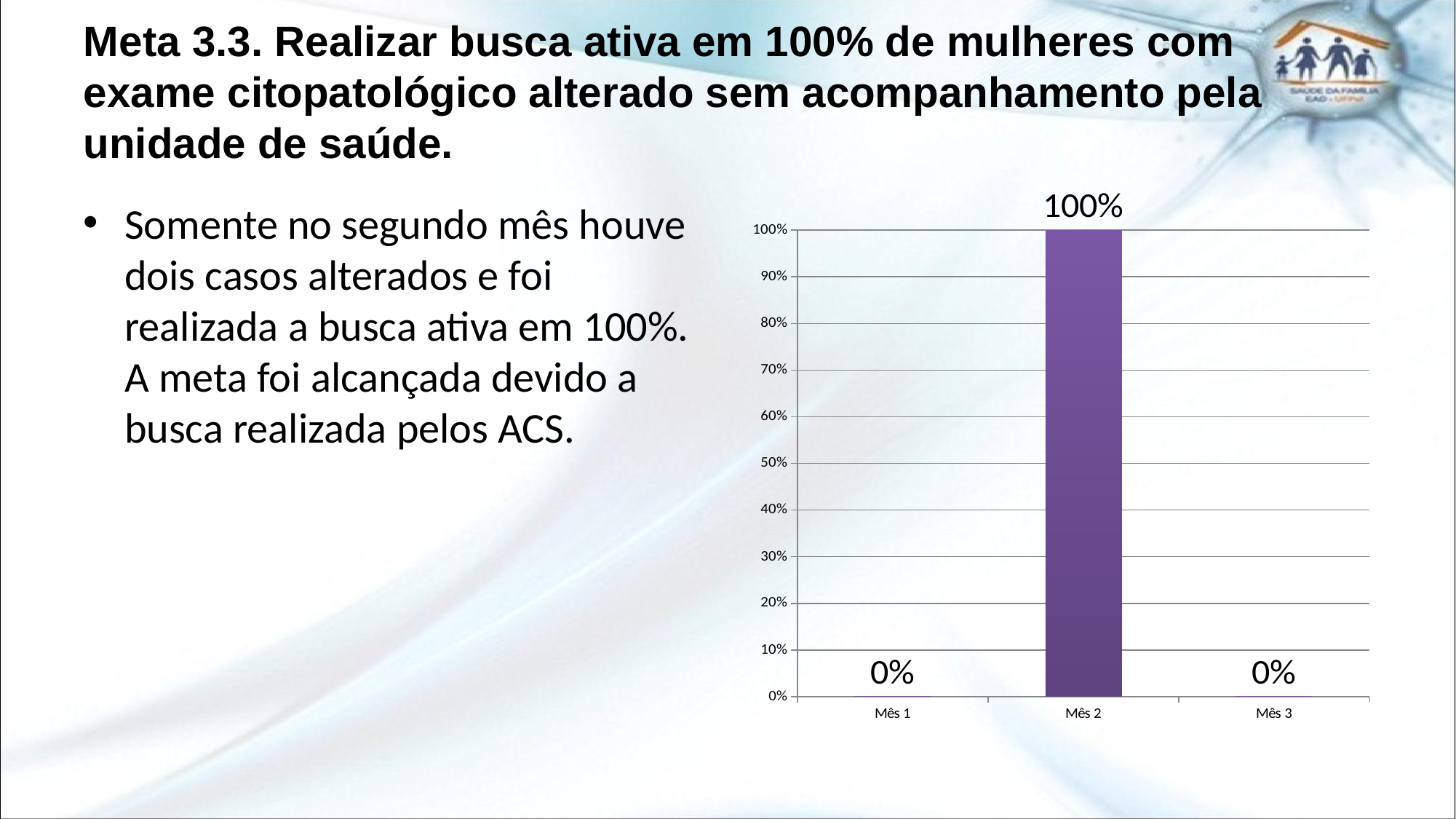
Which month has the highest value? Mês 2 What is the difference between the values for Mês 2 and Mês 1? 100% Is the value for Mês 2 greater or less than 50%? greater What is the value for Mês 2? 100% What is the highest value shown on the y axis of the chart? 100% What kind of chart is shown on the slide? bar chart Which is larger, the value for Mês 2 or the value for Mês 3? Mês 2 What colour is the bar for Mês 2? purple What is the value for Mês 3? 0% How many categories are shown on the x axis of the chart? 3 What is the value for Mês 1? 0%